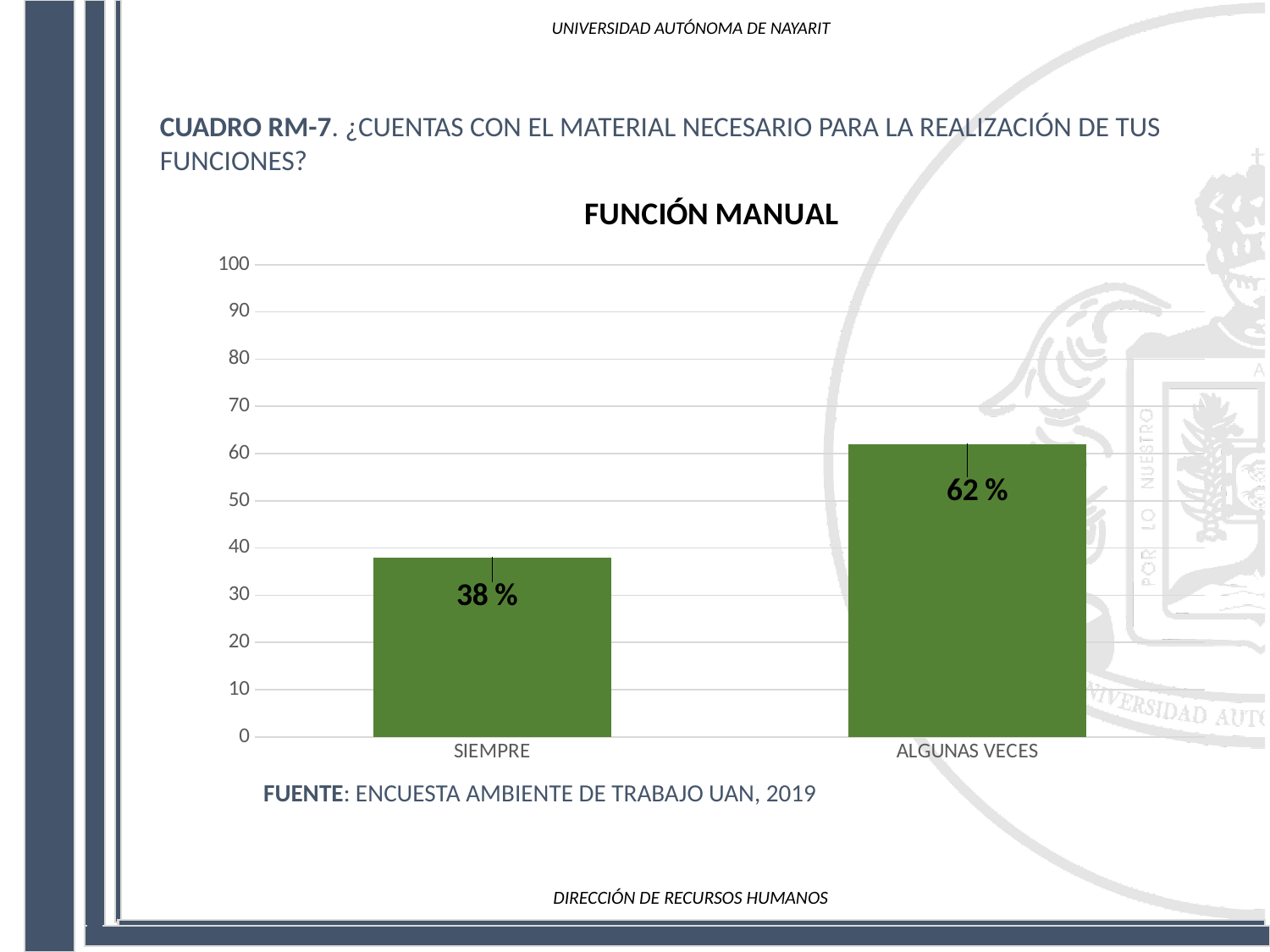
How many categories are shown on the x axis? 2 Which category has the lowest value? SIEMPRE What is the difference between the values for ALGUNAS VECES and SIEMPRE? 24 % What is the title of the chart? FUNCIÓN MANUAL What is the value for SIEMPRE? 38 % Is the value for ALGUNAS VECES greater or less than 60? greater What is the value for ALGUNAS VECES? 62 % Which category has the highest value? ALGUNAS VECES What is the maximum value shown on the y axis? 100 What kind of chart is shown on the slide? bar chart Which is larger, the value for SIEMPRE or the value for ALGUNAS VECES? ALGUNAS VECES Is the value for SIEMPRE greater or less than 40? less